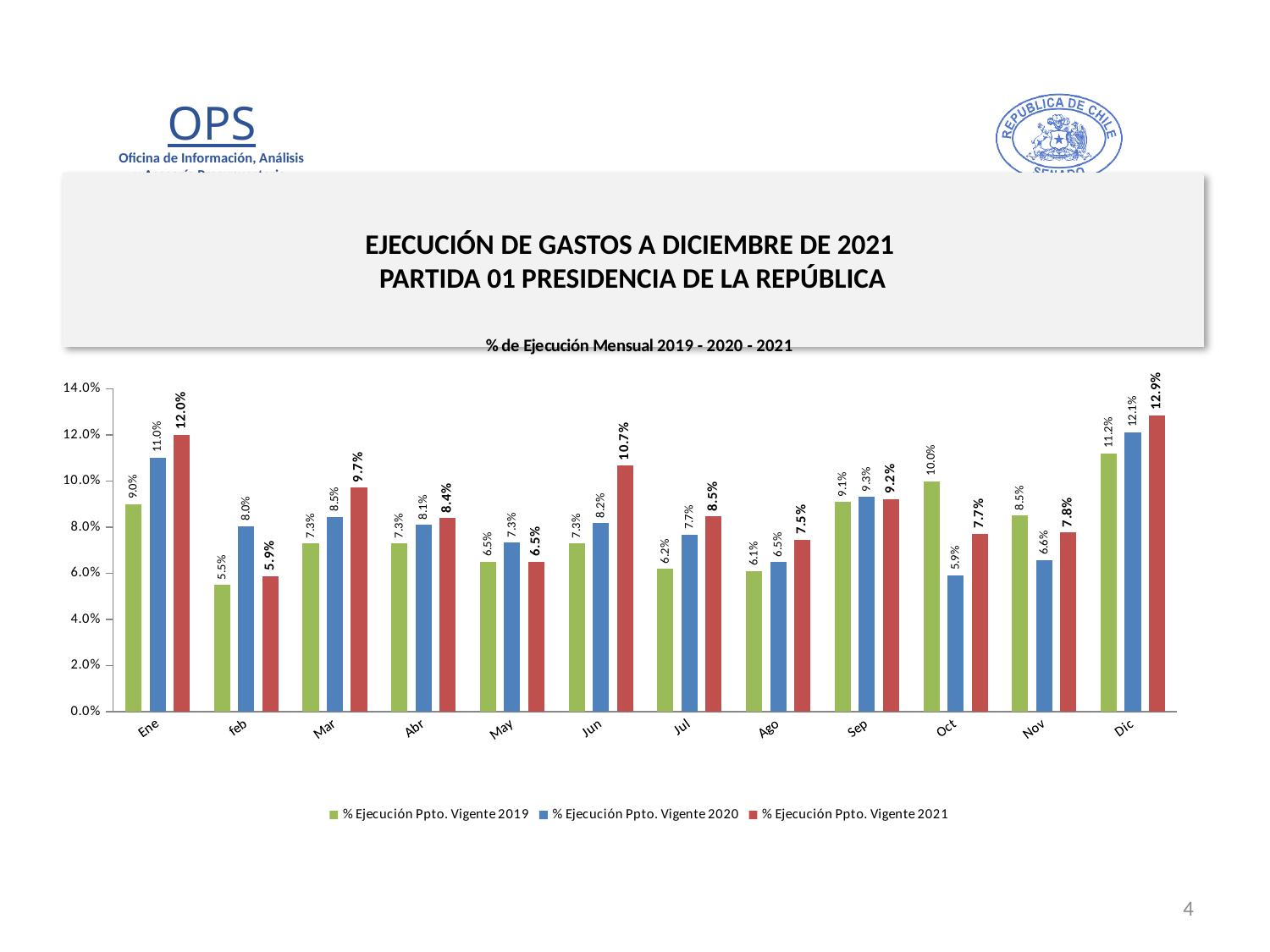
Which month has the lowest % Ejecución Ppto. Vigente 2020 value? Oct What is the % Ejecución Ppto. Vigente 2021 value for Jun? 10.7% Which month has the highest % Ejecución Ppto. Vigente 2021 value? Dic What is the subtitle printed directly above the chart? % de Ejecución Mensual 2019 - 2020 - 2021 Is the % Ejecución Ppto. Vigente 2021 value for Dic greater or less than 12.0%? greater How many series does the legend list? 3 What is the % Ejecución Ppto. Vigente 2020 value for feb? 8.0% How many months are shown on the x axis? 12 Which is larger for Sep: the 2020 value or the 2021 value? 2020 value What is the % Ejecución Ppto. Vigente 2019 value for Oct? 10.0% What kind of chart is shown on the slide? Bar chart What is the difference between the 2021 and 2019 values for Ene? 3.0%